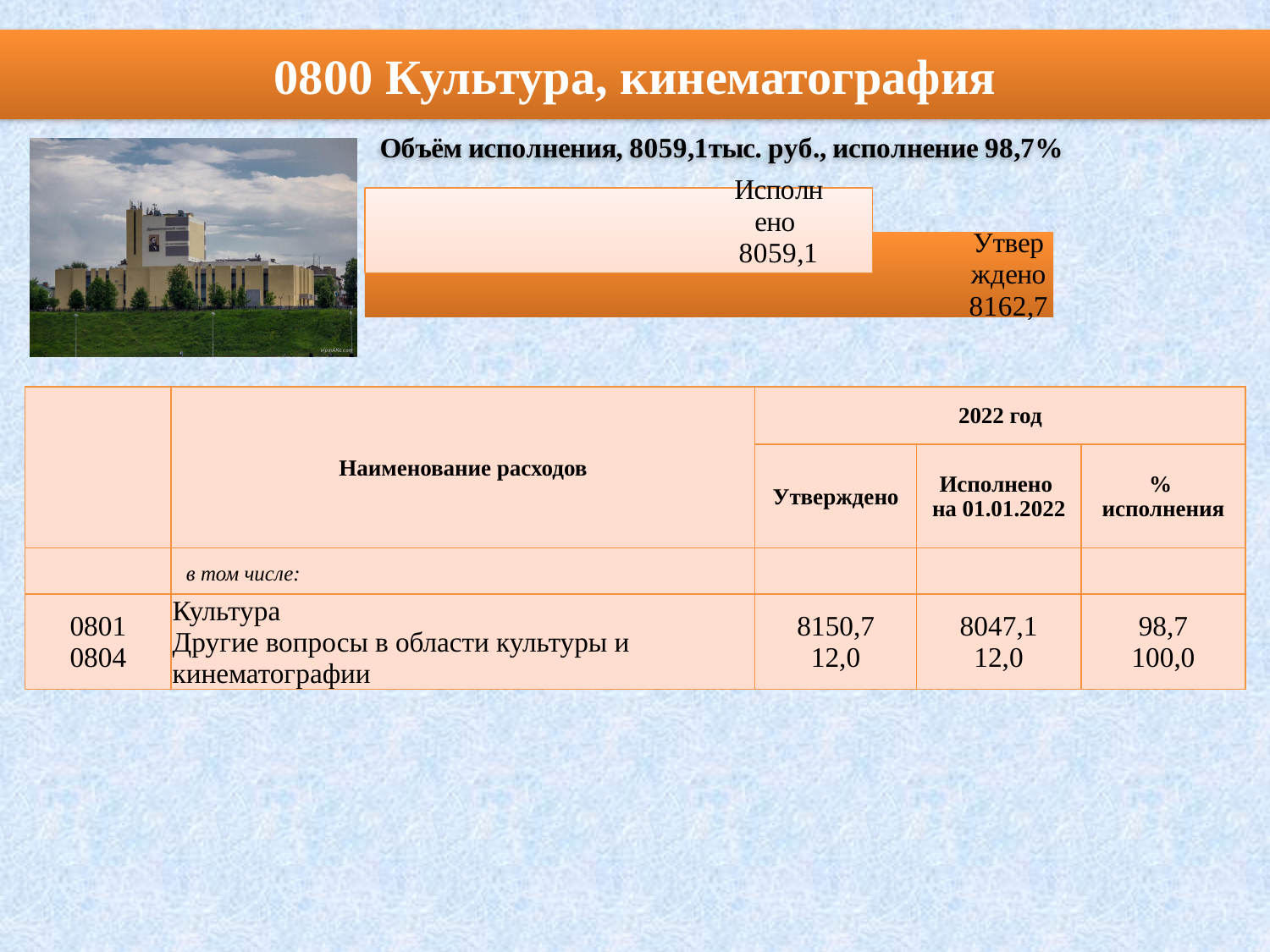
What is the difference between Утверждено and Исполнено? 103,6 What kind of chart is shown on the slide? bar chart Which bar has the lowest value? Исполнено Which bar has the highest value? Утверждено What is the value of the bar labelled Исполнено? 8059,1 What is the value of the bar labelled Утверждено? 8162,7 Which is larger, Утверждено or Исполнено? Утверждено How many bars does the chart have? 2 Are the bars in the chart horizontal or vertical? horizontal What colour is the Утверждено bar? orange